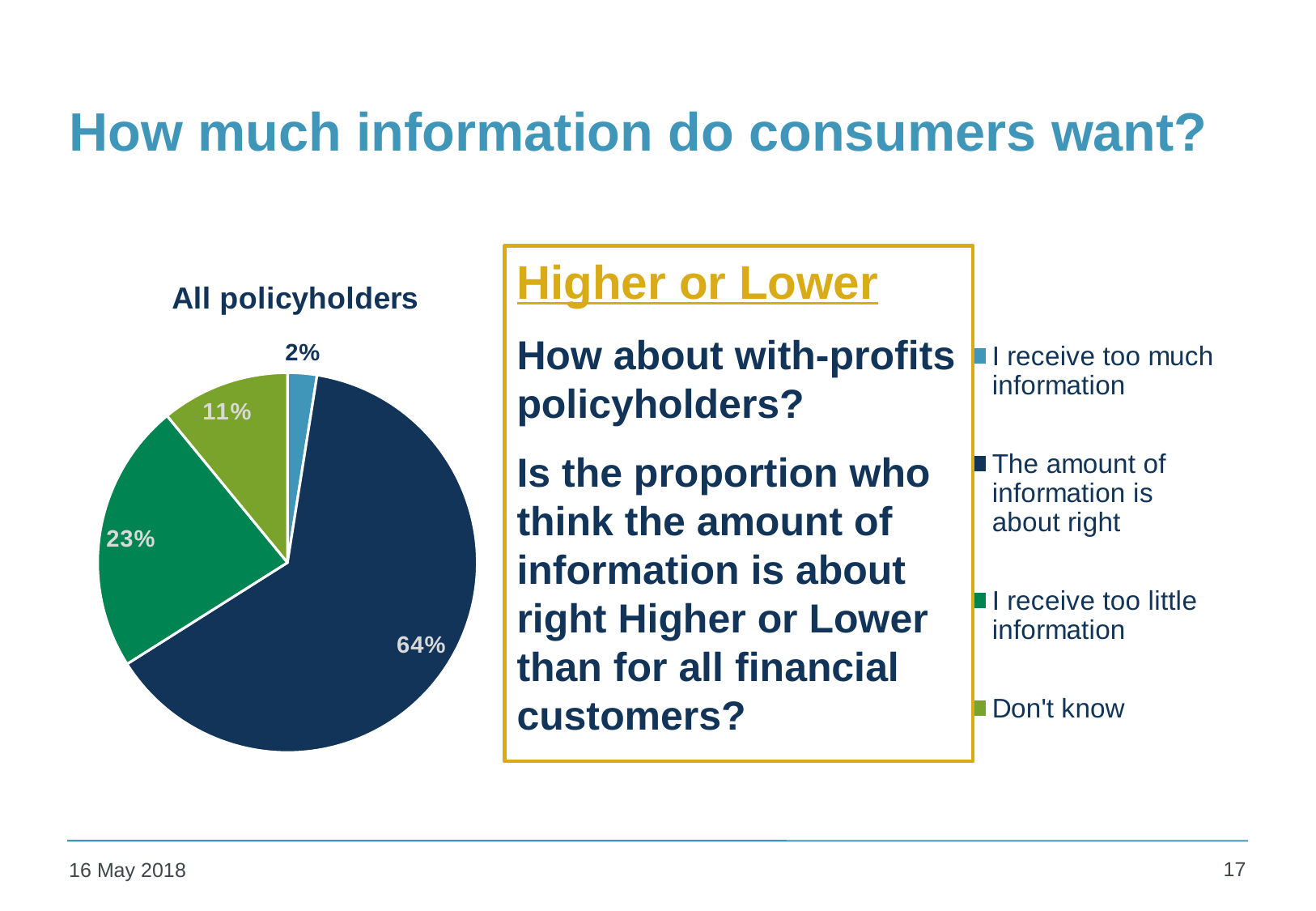
What percentage of policyholders say they receive too little information? 23% What is the difference in percentage points between 'I receive too little information' and 'Don't know'? 12 What type of chart is shown on the slide? Pie chart How many slices does the pie chart have? 4 Which response has the smallest share of the pie? I receive too much information What percentage of policyholders say they receive too much information? 2% What is the title of the pie chart? All policyholders Which is larger: the share for 'I receive too little information' or the share for 'Don't know'? I receive too little information Which response has the largest share of the pie? The amount of information is about right How many entries does the legend list? 4 What percentage of policyholders say the amount of information is about right? 64% What percentage of policyholders answered 'Don't know'? 11%